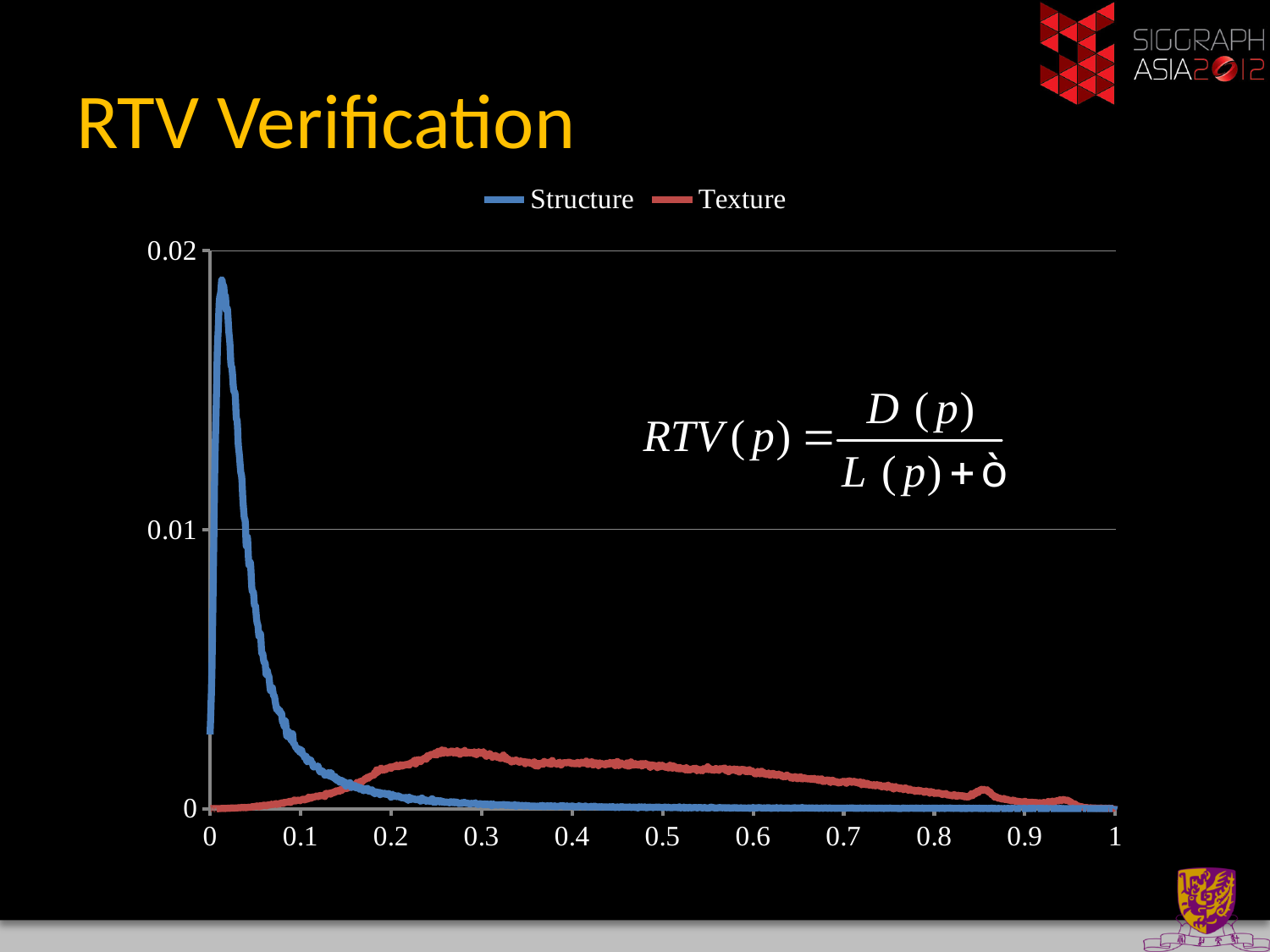
Does the Structure series rise or fall as x increases from 0.1 to 0.3? fall Which series reaches the higher peak, Structure or Texture? Structure What is the highest value shown on the y axis? 0.02 What are the two series named in the legend? Structure and Texture Does the Texture series rise or fall as x increases from 0.6 to 0.9? fall Which colour is used for the Texture series? red Is the Structure series value at x = 0.8 greater or less than 0.01? less How many series does the legend list? 2 What kind of chart is shown on the slide? line chart At x = 0.5, which series has the larger value, Structure or Texture? Texture Is the peak value of the Texture series greater or less than 0.01? less Is the peak value of the Structure series greater or less than 0.01? greater